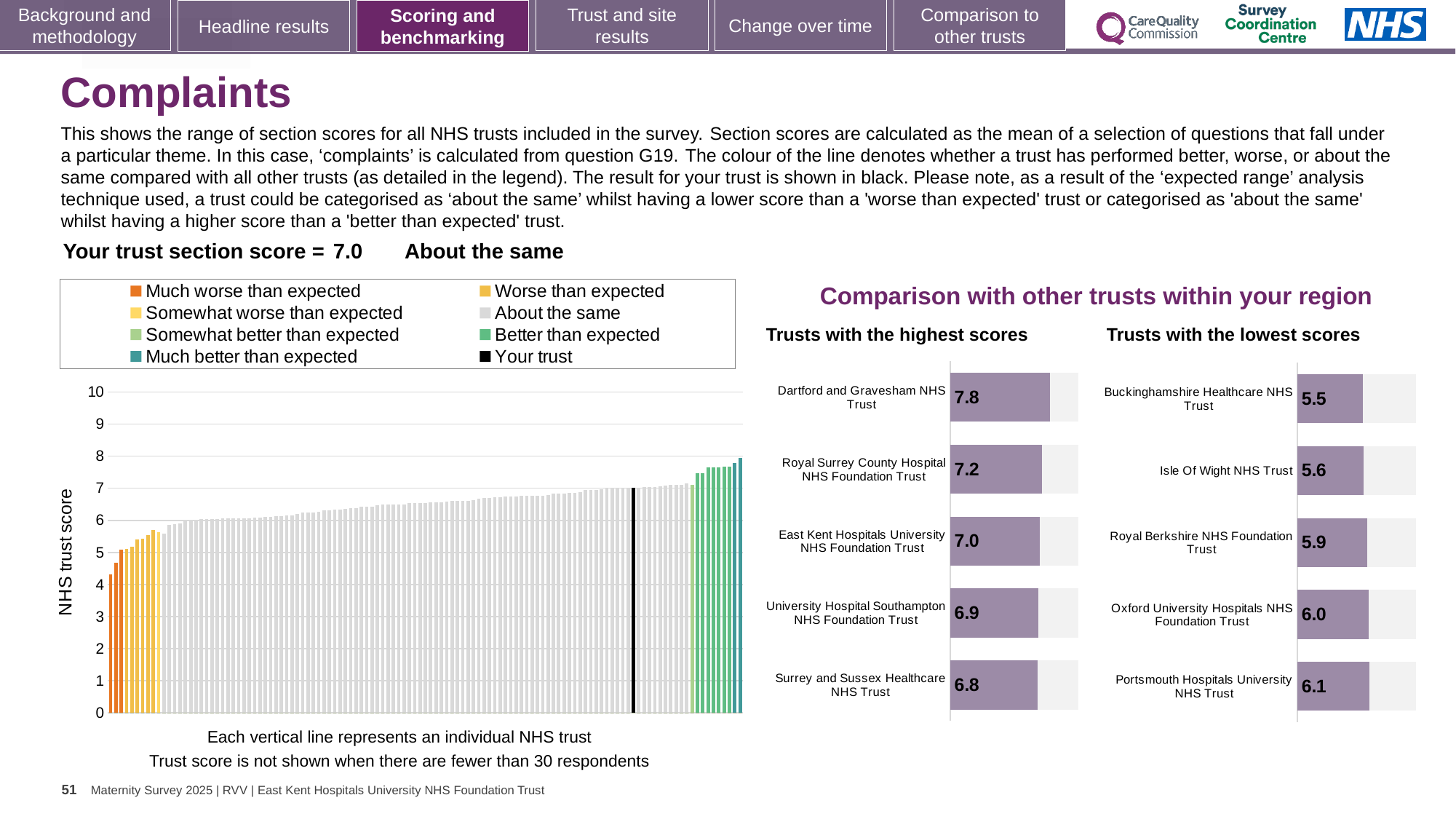
In the NHS trust score chart on the left, is the value for your trust (the black bar) greater or less than 6? greater In the 'Trusts with the highest scores' chart, what is the score for East Kent Hospitals University NHS Foundation Trust? 7.0 What kind of chart is the NHS trust score chart on the left? Bar chart How many entries does the legend of the NHS trust score chart list? 8 In the 'Trusts with the lowest scores' chart, which trust has the lowest score? Buckinghamshire Healthcare NHS Trust In the 'Trusts with the lowest scores' chart, what is the score for Isle Of Wight NHS Trust? 5.6 In the 'Trusts with the lowest scores' chart, what is the difference between the scores of Portsmouth Hospitals University NHS Trust and Buckinghamshire Healthcare NHS Trust? 0.6 In the 'Trusts with the lowest scores' chart, which has the larger score: Royal Berkshire NHS Foundation Trust or Oxford University Hospitals NHS Foundation Trust? Oxford University Hospitals NHS Foundation Trust In the 'Trusts with the highest scores' chart, which trust has the highest score? Dartford and Gravesham NHS Trust How many trusts are shown in the 'Trusts with the highest scores' chart? 5 In the 'Trusts with the highest scores' chart, what is the score for Dartford and Gravesham NHS Trust? 7.8 In the 'Trusts with the highest scores' chart, what is the difference between the scores of Dartford and Gravesham NHS Trust and Surrey and Sussex Healthcare NHS Trust? 1.0